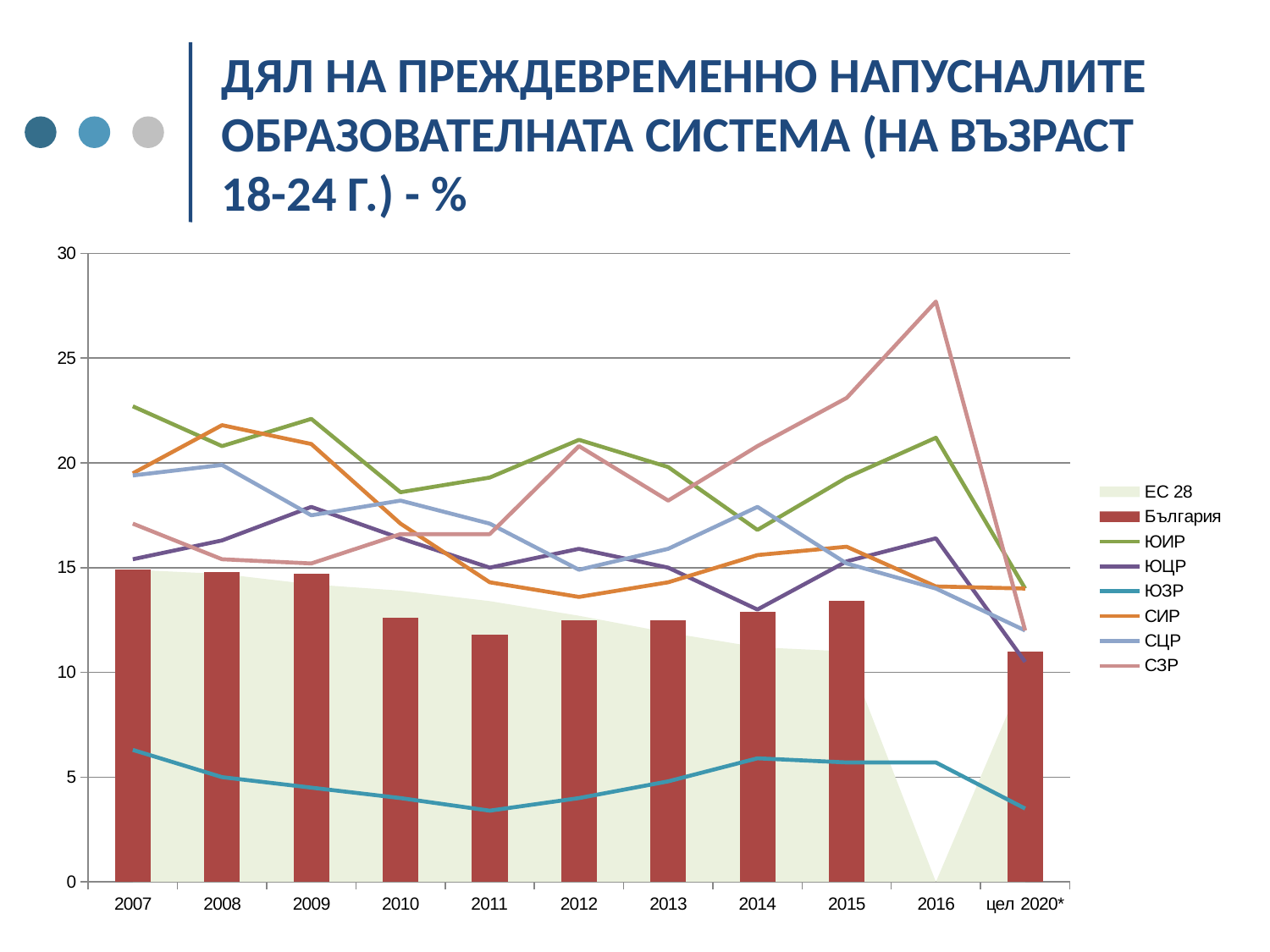
How many series does the legend list? 8 Is the value for СЗР in 2016 greater or less than 25? greater In 2016, which is larger: the value for СЗР or the value for ЮИР? СЗР Is the value for ЮЗР in 2011 greater or less than 5? less Is the value for ЮИР in 2007 greater or less than 20? greater Does the ЮЗР series rise or fall from 2007 to 2011? Falls How many categories are shown on the x axis? 11 Which line series has the lowest values across the whole period? ЮЗР How is the България series drawn on the chart? As bars What colour are the bars for България? Red In which year does the СЗР series reach its highest value? 2016